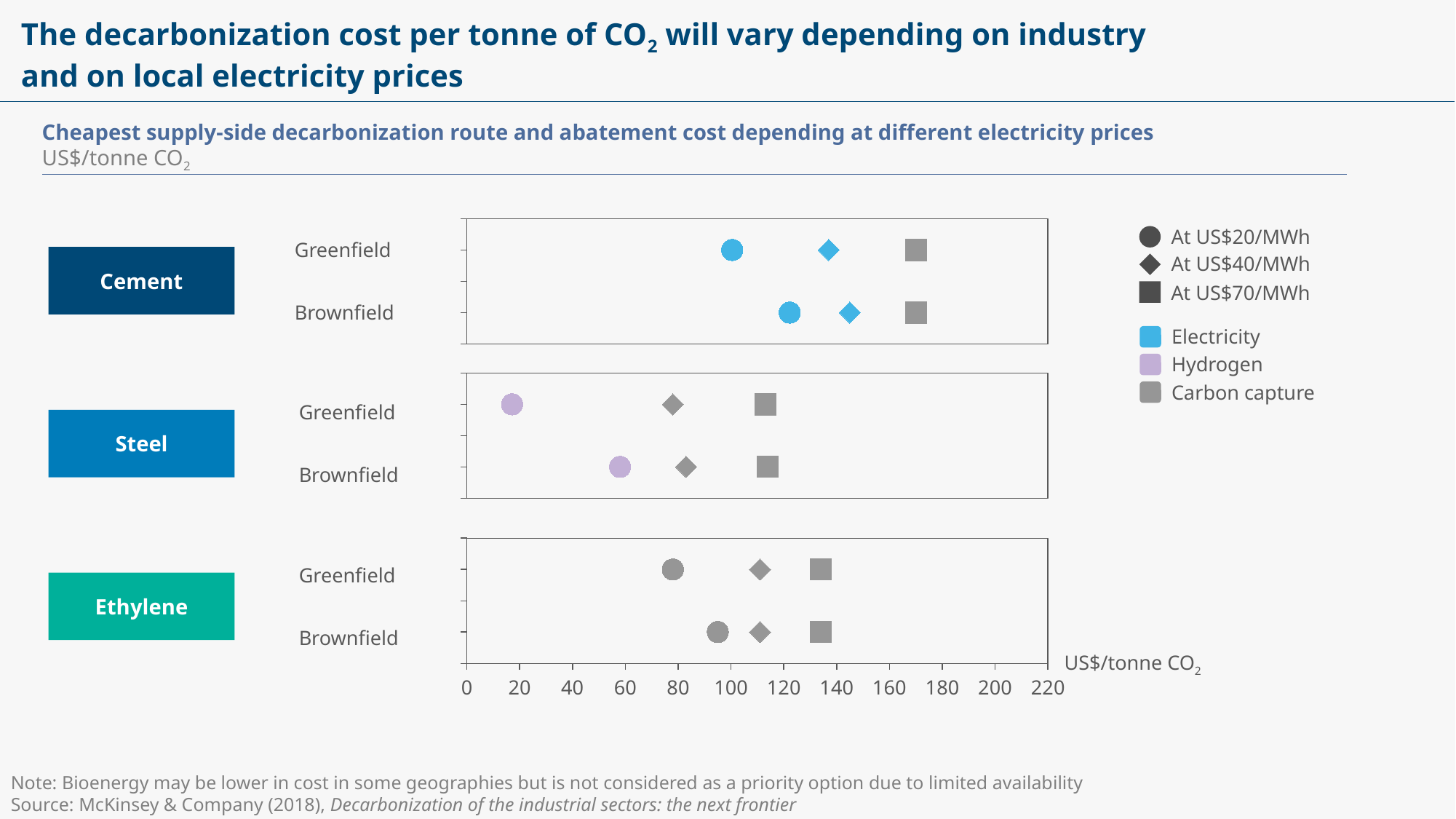
Is the abatement cost for Steel Greenfield at US$20/MWh greater or less than 40? less At US$20/MWh, which has the higher abatement cost: Cement Greenfield or Steel Greenfield? Cement Greenfield Which industry and plant type has the lowest abatement cost shown on the chart? Steel Greenfield According to the marker colours, which decarbonization route is cheapest for Steel? Hydrogen Is the abatement cost for Cement Brownfield at US$70/MWh greater or less than 160? greater Is the abatement cost for Ethylene Brownfield at US$40/MWh greater or less than 100? greater For Ethylene Greenfield, does the abatement cost rise or fall as the electricity price increases from US$20/MWh to US$70/MWh? rises What kind of chart is used to show the abatement costs on this slide? dot plot Which industry has the highest abatement cost at US$70/MWh? Cement How many electricity price levels does the legend list? 3 At US$20/MWh, which has the higher abatement cost: Steel Brownfield or Steel Greenfield? Steel Brownfield How many industries are shown in the chart? 3